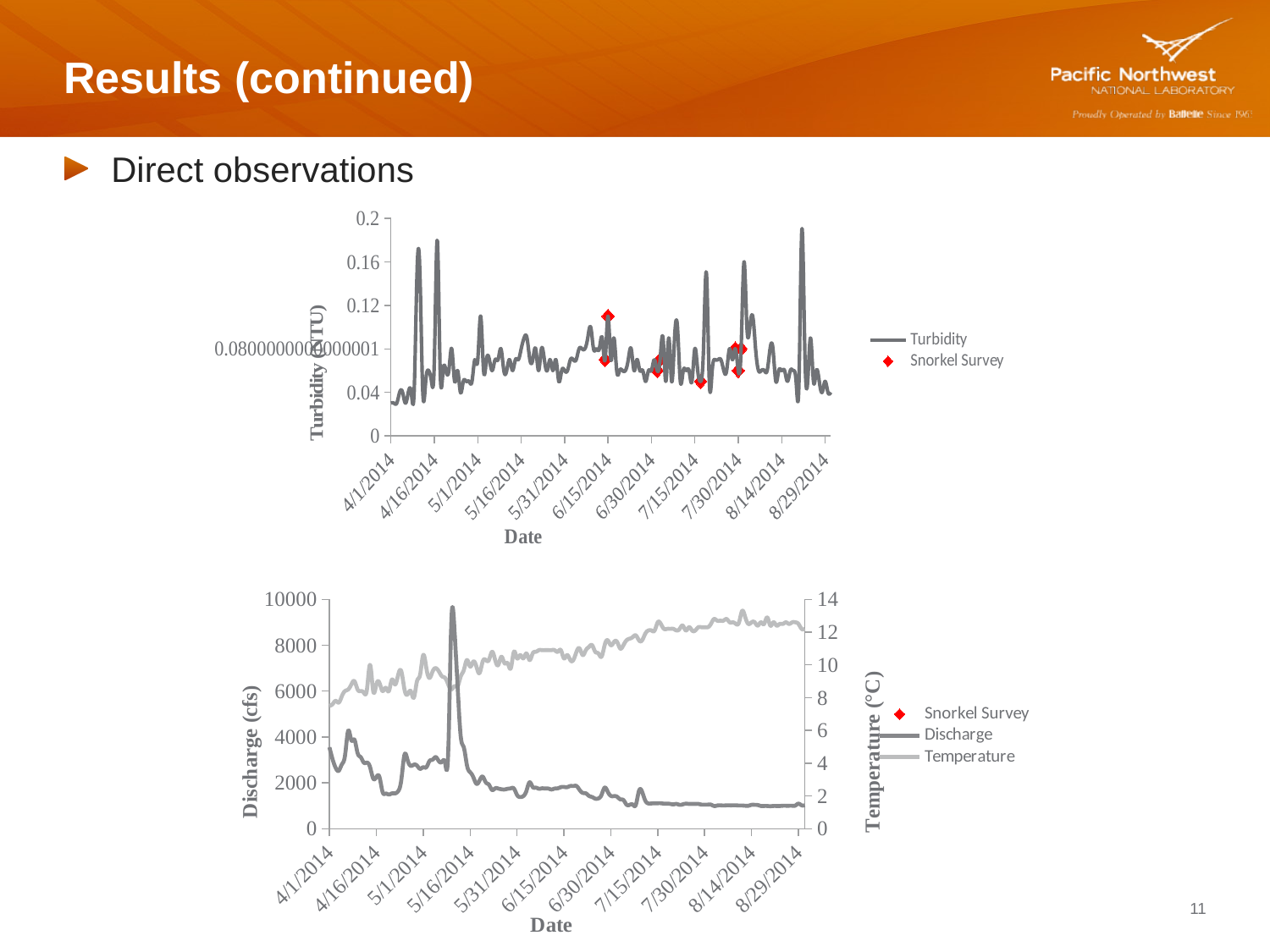
What kind of chart is the top chart on the slide? Line chart In the top chart, how many entries does the legend list? 2 In the bottom chart, is the Discharge value at 8/29/2014 greater or less than 2000? less In the bottom chart, is the highest Discharge value greater or less than 8000? greater In the top chart, what is the label of the vertical axis? Turbidity (NTU) In the bottom chart, does the Discharge series generally rise or fall from April to August 2014? Fall What kind of chart is the bottom chart on the slide? Line chart In the bottom chart, is the Temperature value at 8/29/2014 greater or less than 10? greater In the bottom chart, does the Temperature series generally rise or fall from April to August 2014? Rise In the bottom chart, what is the label of the right-hand vertical axis? Temperature (°C) In the bottom chart, how many entries does the legend list? 3